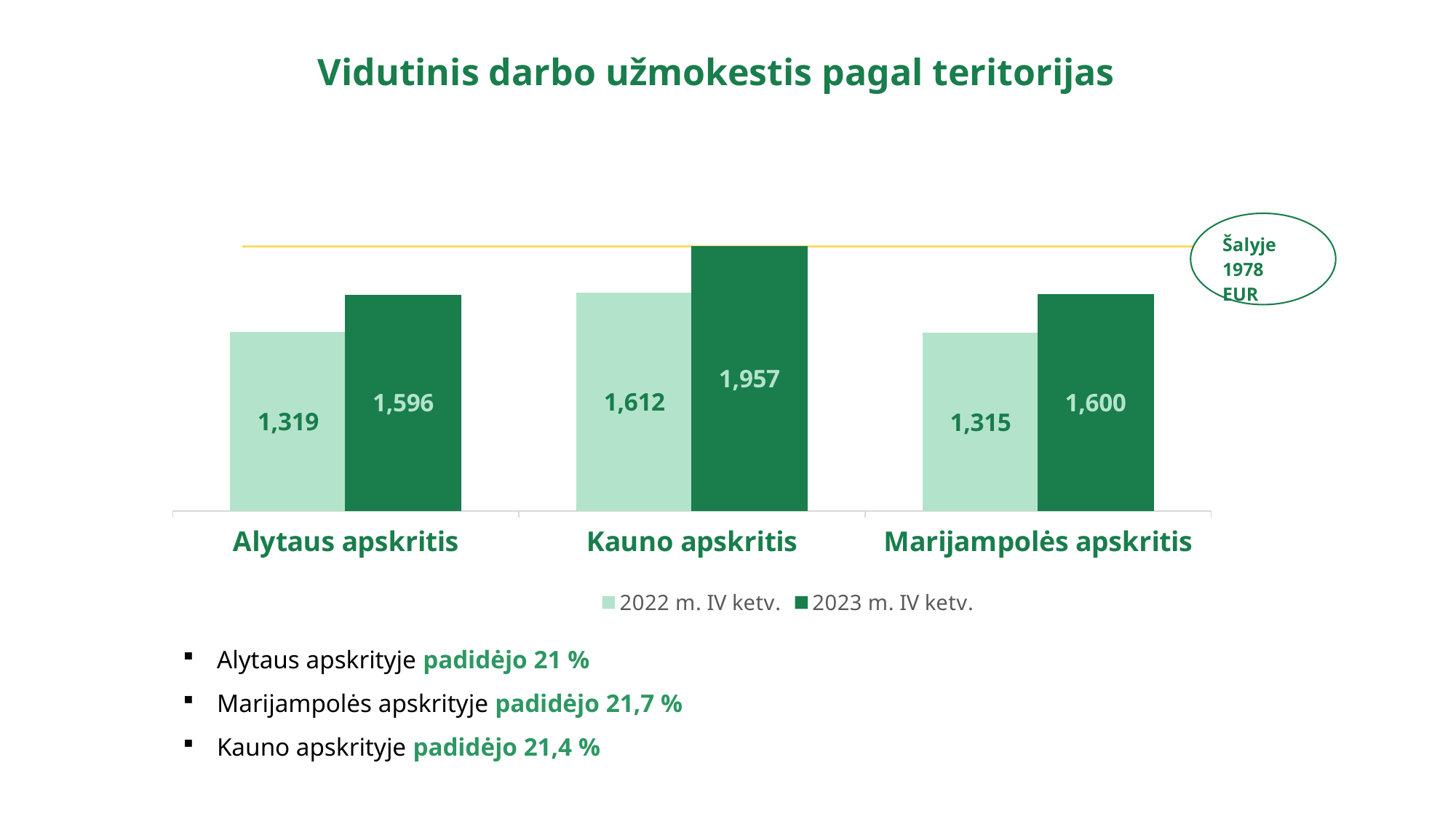
What is the difference between the 2023 m. IV ketv. and 2022 m. IV ketv. values for Alytaus apskritis? 277 What is the value for Kauno apskritis in the 2023 m. IV ketv. series? 1,957 Which category has the highest value in the 2022 m. IV ketv. series? Kauno apskritis What is the value for Alytaus apskritis in the 2022 m. IV ketv. series? 1,319 How many categories are shown on the x axis of the chart? 3 How many series does the legend list? 2 What is the value for Marijampolės apskritis in the 2023 m. IV ketv. series? 1,600 What is the value for Marijampolės apskritis in the 2022 m. IV ketv. series? 1,315 Which category has the highest value in the 2023 m. IV ketv. series? Kauno apskritis Which is larger: the 2023 m. IV ketv. value for Kauno apskritis or the 2023 m. IV ketv. value for Alytaus apskritis? Kauno apskritis What kind of chart is shown on the slide? Bar chart What is the difference between the 2023 m. IV ketv. and 2022 m. IV ketv. values for Kauno apskritis? 345